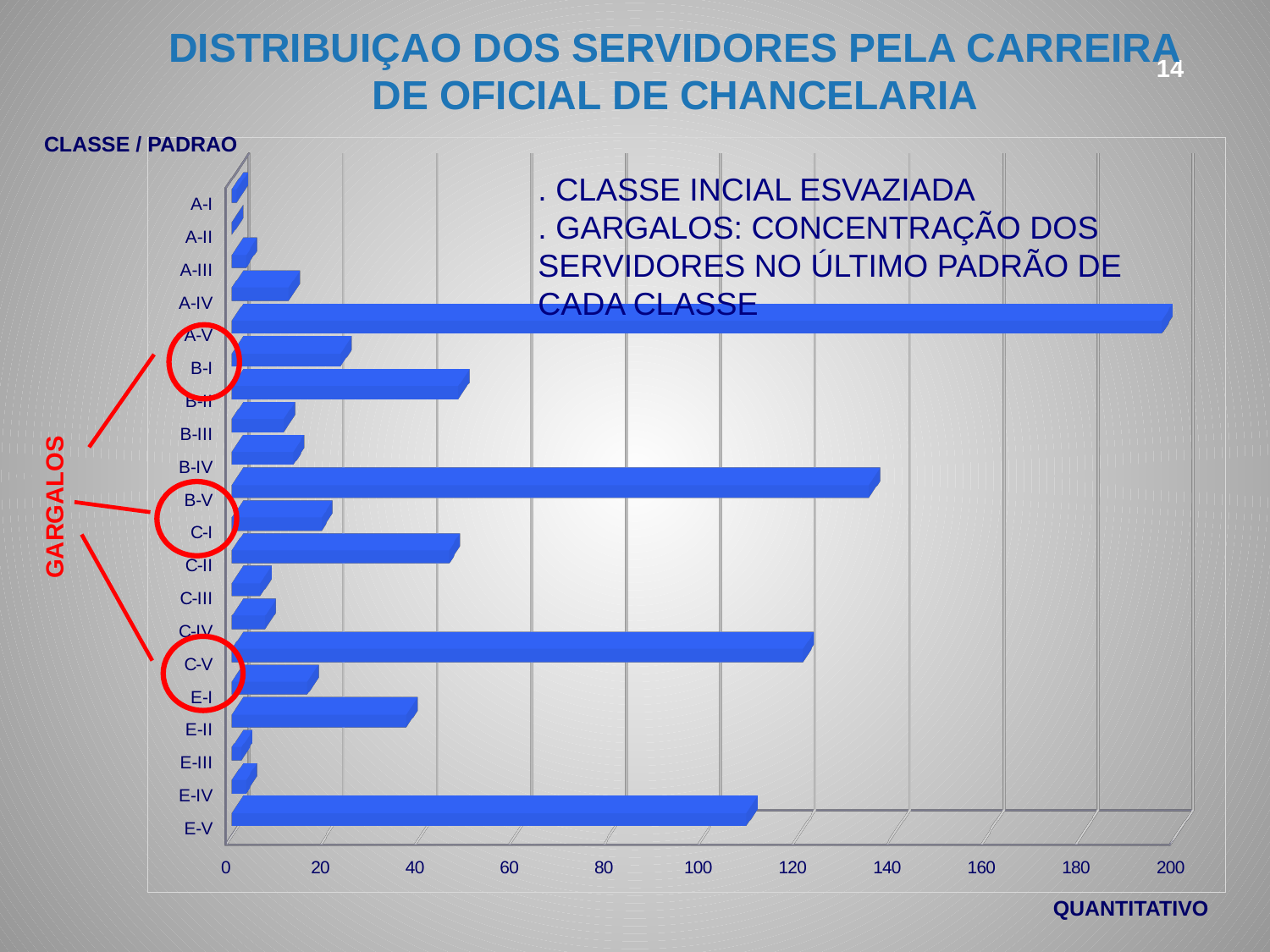
Which is larger, the value for B-V or the value for C-V? B-V Is the value for A-IV greater or less than 20? less Is the value for B-V greater or less than 120? greater Which is larger, the value for E-V or the value for A-V? A-V What kind of chart is shown on the slide? bar chart Is the value for B-II greater or less than 40? greater Which category has the highest value on the chart? A-V How many categories (classe/padrão) are plotted on the chart? 20 What is the label of the horizontal (value) axis of the chart? QUANTITATIVO